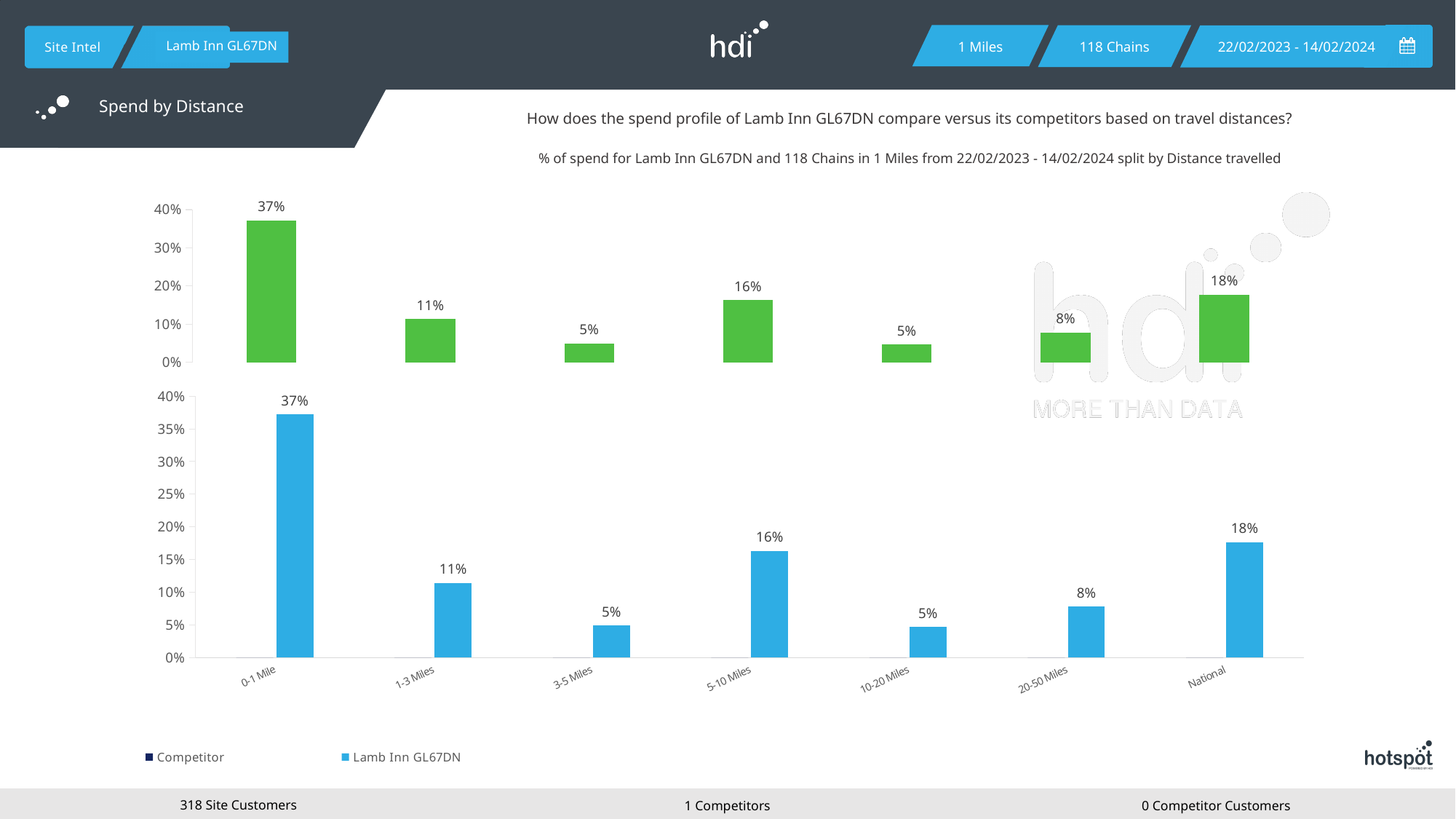
On the bottom chart, which category has the highest value for Lamb Inn GL67DN? 0-1 Mile On the bottom chart, what is the value for Lamb Inn GL67DN in the 0-1 Mile category? 37% On the bottom chart, what is the value for Lamb Inn GL67DN in the National category? 18% How many series does the legend of the bottom chart list? 2 How many distance categories are shown on the x axis of the bottom chart? 7 On the bottom chart, what is the value for Lamb Inn GL67DN in the 20-50 Miles category? 8% On the bottom chart, which is larger for Lamb Inn GL67DN: the National value or the 5-10 Miles value? National What are the two series named in the legend of the bottom chart? Competitor and Lamb Inn GL67DN On the bottom chart, what is the difference between the Lamb Inn GL67DN values for 0-1 Mile and 1-3 Miles? 26% What kind of chart is the bottom chart? Bar chart On the bottom chart, what is the value for Lamb Inn GL67DN in the 5-10 Miles category? 16% On the bottom chart, is the Lamb Inn GL67DN value for 1-3 Miles greater or less than 15%? less